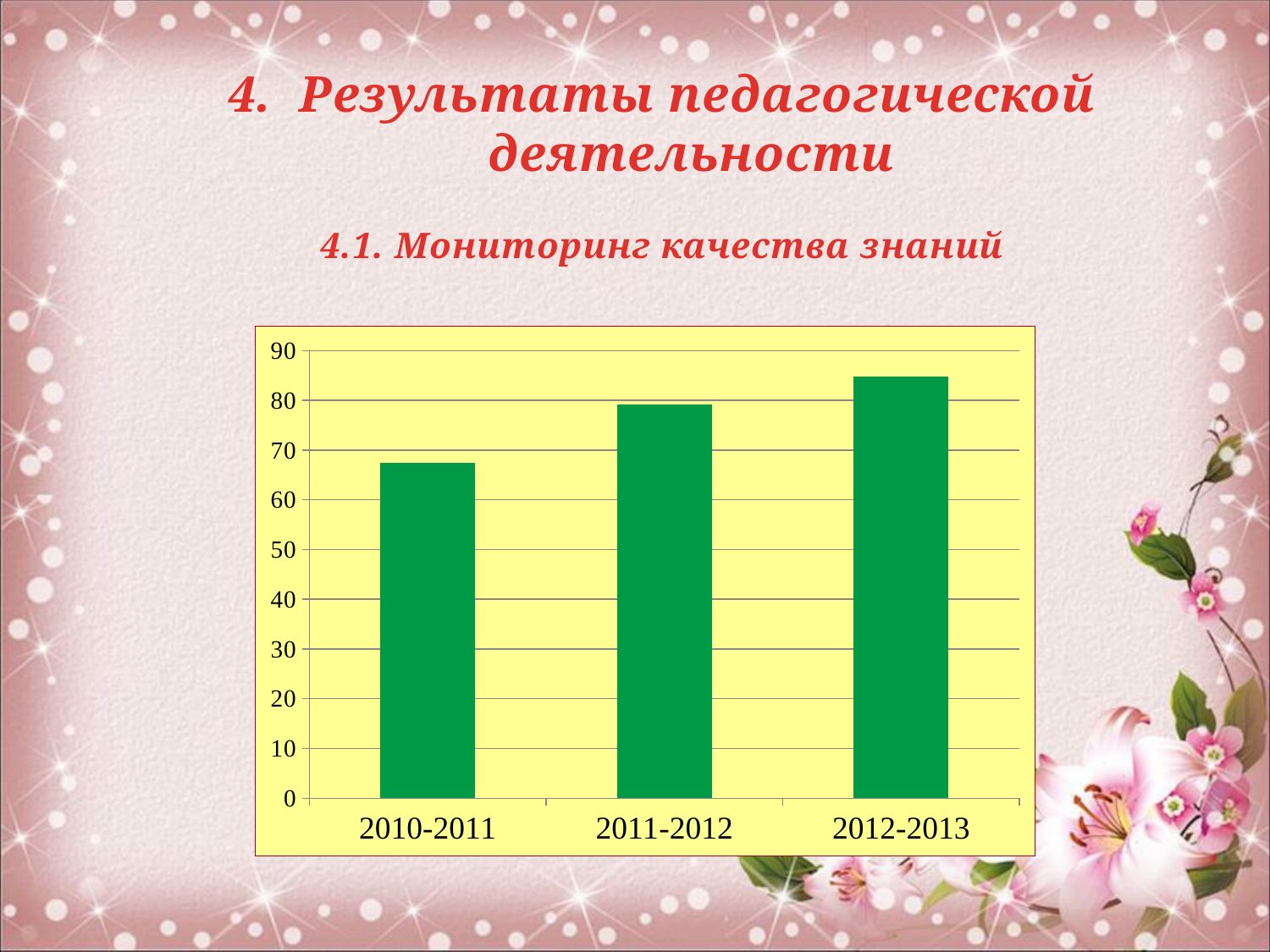
Is the value for 2011-2012 greater or less than 70? greater Which is larger, the value for 2011-2012 or the value for 2010-2011? 2011-2012 Is the value for 2012-2013 greater or less than 80? greater Which school year has the highest bar in the chart? 2012-2013 Do the values rise or fall from 2010-2011 to 2012-2013? rise What is the subtitle above the chart? 4.1. Мониторинг качества знаний Is the value for 2010-2011 greater or less than 70? less What is the maximum value shown on the vertical axis of the chart? 90 What kind of chart is shown on the slide? bar chart How many categories (school years) are shown on the x axis of the chart? 3 Which school year has the lowest bar in the chart? 2010-2011